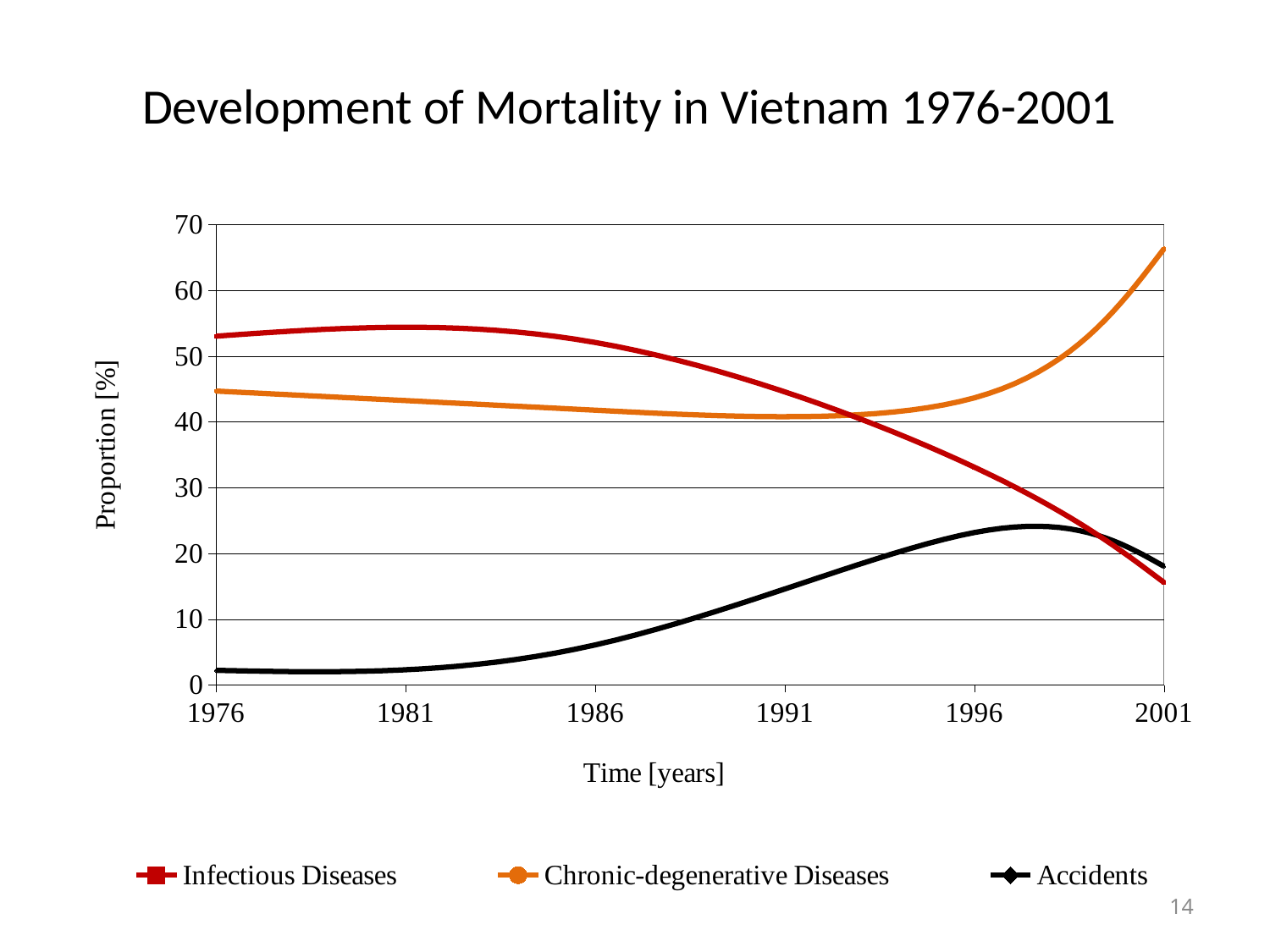
What kind of chart is shown on the slide? line chart Which series has the lowest value in 2001? Infectious Diseases Is the value for Accidents in 1976 greater or less than 10? less Is the value for Chronic-degenerative Diseases in 2001 greater or less than 60? greater In 1986, which is larger: Infectious Diseases or Chronic-degenerative Diseases? Infectious Diseases What is the label of the y axis? Proportion [%] Does the Accidents line rise or fall from 1976 to 2001? rise Does the Infectious Diseases line rise or fall from 1976 to 2001? fall How many series does the legend list? 3 Is the value for Infectious Diseases in 1976 greater or less than 50? greater Which series has the highest value in 1976? Infectious Diseases What is the title of the chart? Development of Mortality in Vietnam 1976-2001